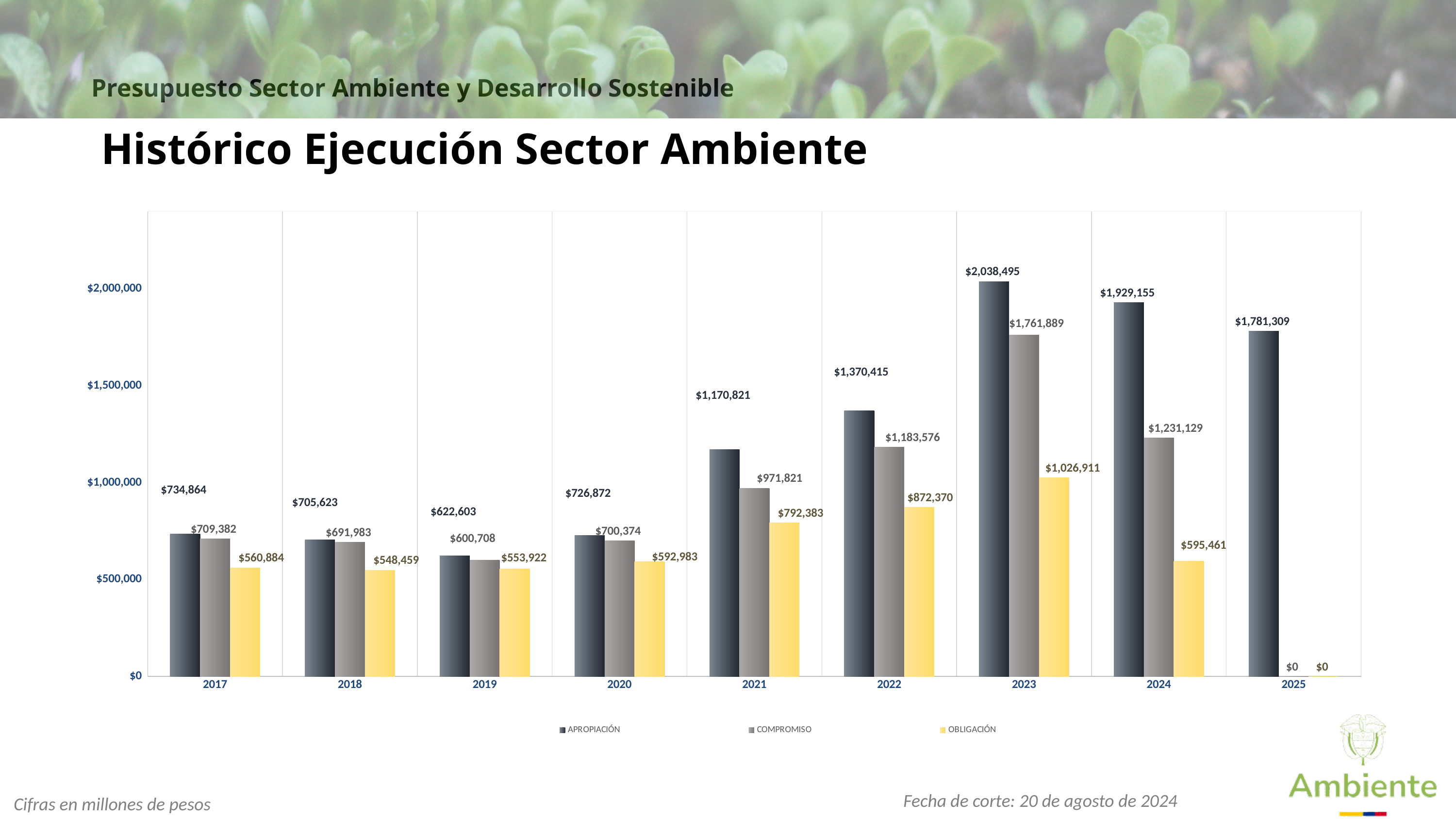
Which year has the highest APROPIACIÓN value? 2023 What kind of chart is shown on the slide? bar chart Which is larger, the OBLIGACIÓN value for 2022 or the OBLIGACIÓN value for 2024? 2022 What is the difference between the APROPIACIÓN and COMPROMISO values in 2023? $276,606 What is the title of the chart? Histórico Ejecución Sector Ambiente What is the APROPIACIÓN value for 2023? $2,038,495 Which year has the lowest APROPIACIÓN value? 2019 What is the OBLIGACIÓN value for 2021? $792,383 How many years are shown on the x axis? 9 What is the COMPROMISO value for 2024? $1,231,129 Is the COMPROMISO value for 2022 greater or less than $1,000,000? greater How many series does the legend list? 3